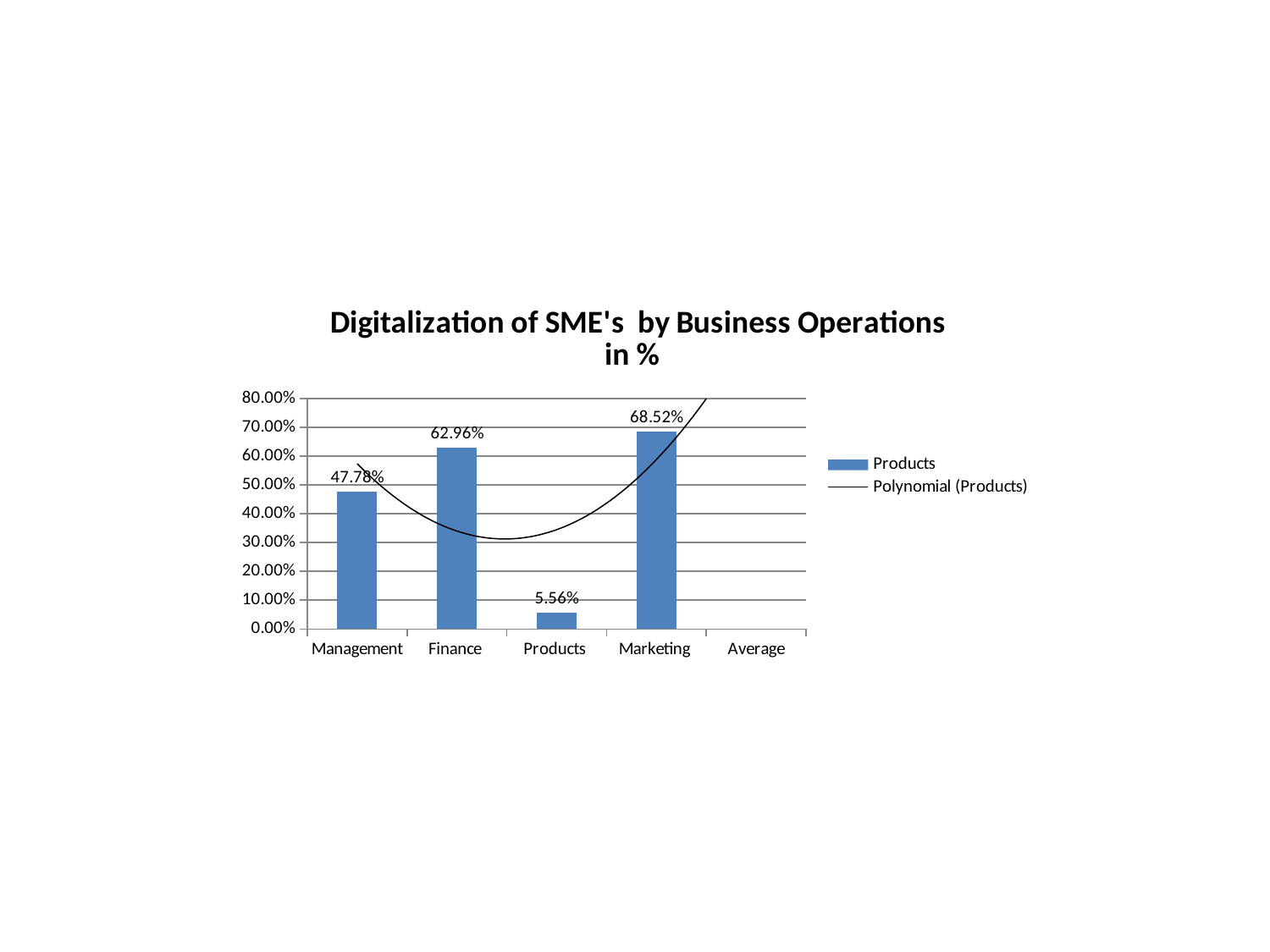
How many bars are plotted on the chart? 4 What is the value for Finance? 62.96% Which is larger, the value for Management or the value for Finance? Finance What kind of chart is this? bar chart Is the value for Management greater or less than 50.00%? less What is the value for Products? 5.56% Which category has the lowest plotted value? Products Which category has the highest value? Marketing How many entries does the legend list? 2 What is the difference between the values for Finance and Management? 15.18% What is the value for Management? 47.78% What is the difference between the values for Marketing and Finance? 5.56%